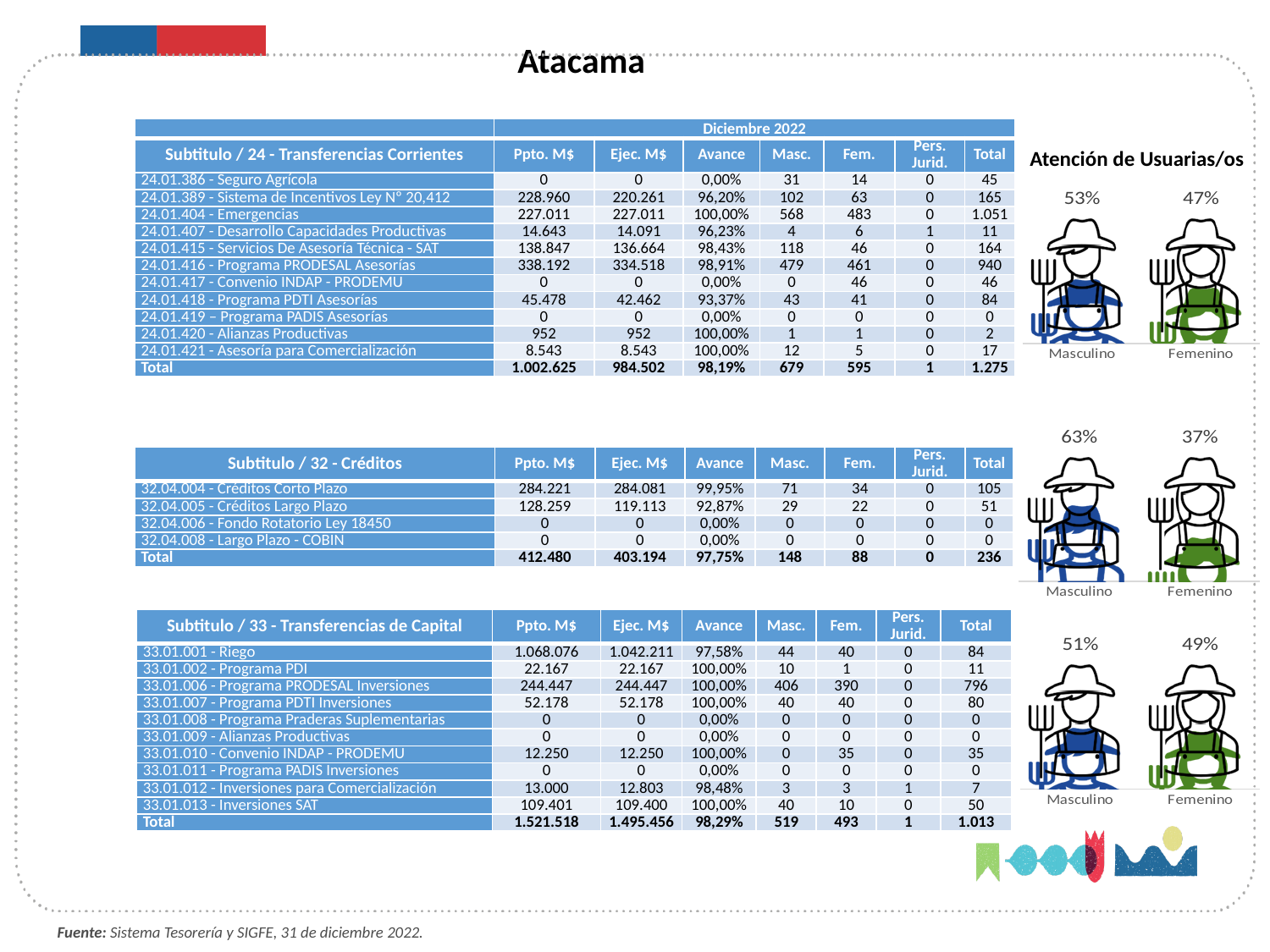
How many categories does each of the charts on the right side of the slide show? 2 What is the title shown above the top chart on the right side of the slide? Atención de Usuarias/os In the bottom chart on the right side of the slide, which category has the lower percentage? Femenino In the top 'Atención de Usuarias/os' chart, what percentage is shown for Masculino? 53% In the bottom chart on the right side of the slide, what percentage is shown for Masculino? 51% In the bottom chart on the right side of the slide, what percentage is shown for Femenino? 49% In the middle chart on the right side of the slide, which category has the higher percentage, Masculino or Femenino? Masculino In the top 'Atención de Usuarias/os' chart, what is the difference in percentage points between Masculino and Femenino? 6 In the middle chart on the right side of the slide, what percentage is shown for Femenino? 37% In the middle chart on the right side of the slide, what is the difference in percentage points between Masculino and Femenino? 26 In the middle chart on the right side of the slide, what percentage is shown for Masculino? 63% In the top 'Atención de Usuarias/os' chart, what percentage is shown for Femenino? 47%